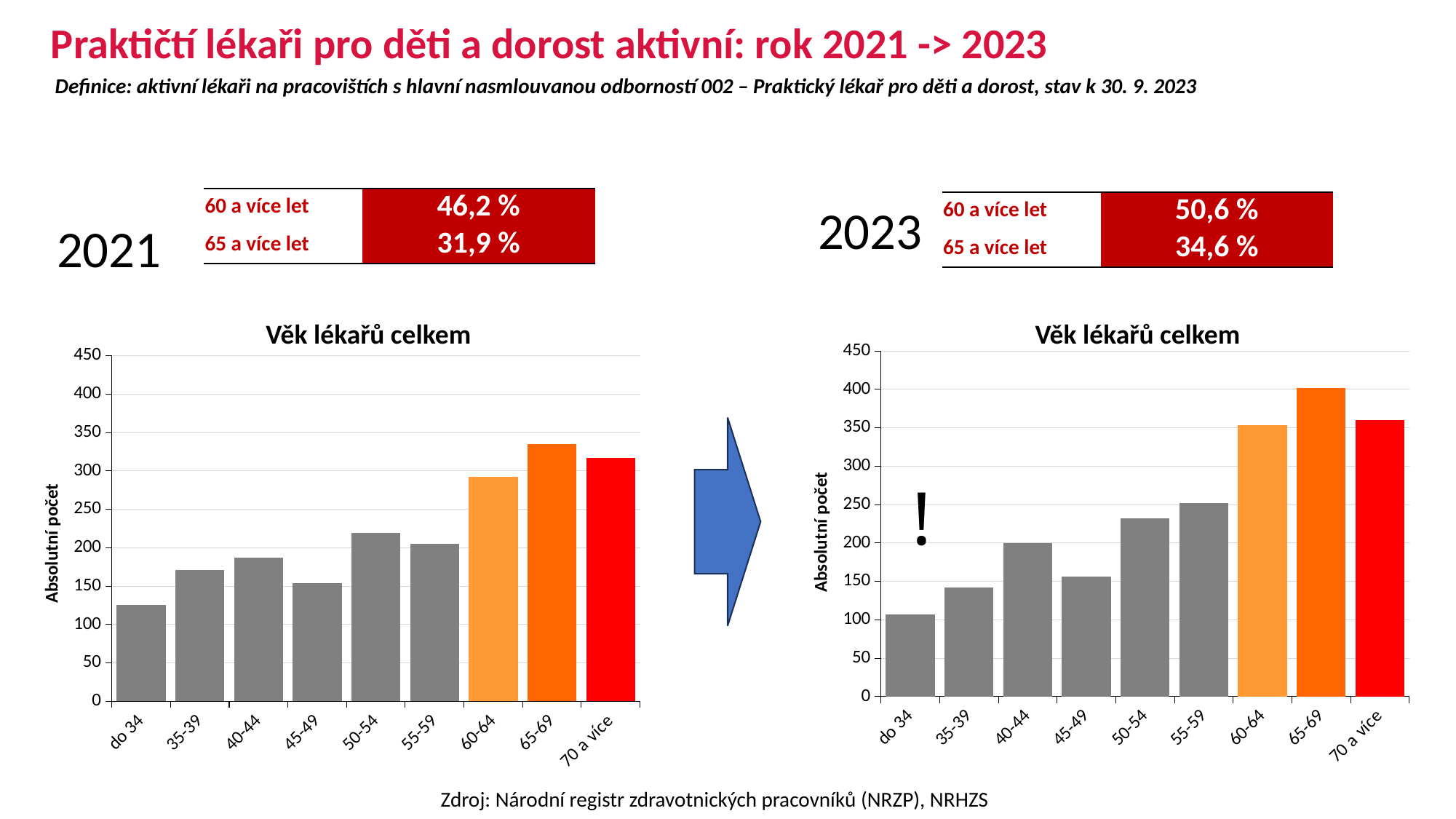
In the 2021 chart, which age category has the lowest value? do 34 What kind of chart is the 2023 chart? bar chart In the 2021 chart, which is larger, the value for 50-54 or the value for 45-49? 50-54 In the 2023 chart, which age category has the lowest value? do 34 In the 2021 chart, is the value for 60-64 greater or less than 300? less In the 2021 chart, which age category has the highest value? 65-69 In the 2023 chart, which age category has the highest value? 65-69 What is the y-axis label of the 2021 chart? Absolutní počet In the 2023 chart, which is larger, the value for 70 a více or the value for 60-64? 70 a více How many age categories are shown on the x axis of the 2021 chart? 9 In the 2023 chart, is the value for do 34 greater or less than 150? less